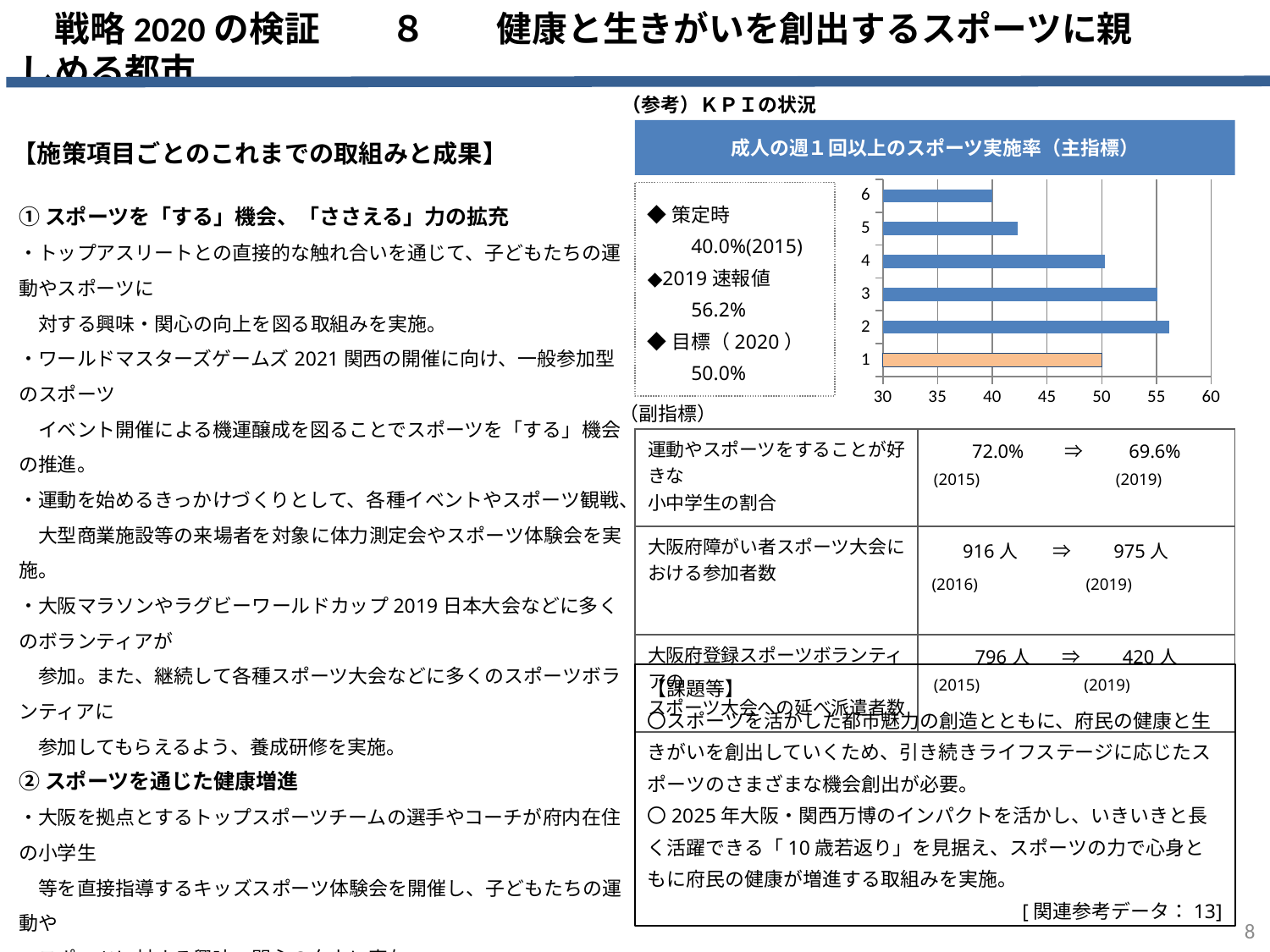
On the bar chart, which has the larger value, category 1 or category 5? category 1 Is the value for category 6 on the bar chart greater or less than 45? less What is the title of the bar chart? 成人の週１回以上のスポーツ実施率（主指標） What colour is the bar for category 1 on the bar chart? orange What kind of chart is shown under the title 成人の週１回以上のスポーツ実施率（主指標）? bar chart Is the value for category 4 on the bar chart greater or less than 45? greater How many categories are plotted on the bar chart? 6 On the bar chart, which has the larger value, category 2 or category 6? category 2 Is the value for category 5 on the bar chart greater or less than 45? less